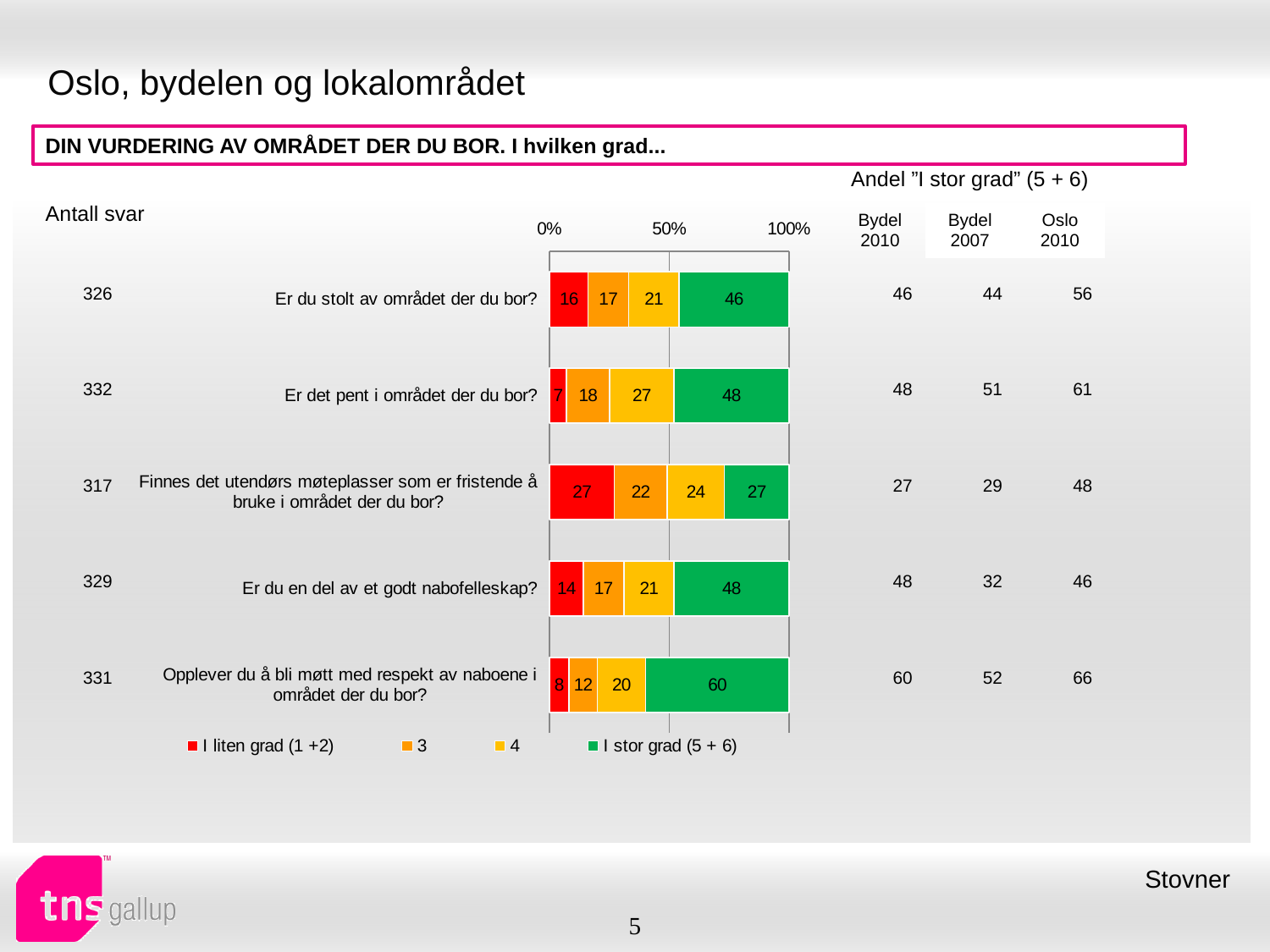
What is the value of series "4" for "Finnes det utendørs møteplasser som er fristende å bruke i området der du bor?"? 24 Which has a larger "I liten grad (1 +2)" value: "Er du stolt av området der du bor?" or "Er du en del av et godt nabofelleskap?"? Er du stolt av området der du bor? What is the value of "I stor grad (5 + 6)" for "Er du stolt av området der du bor?"? 46 How many questions (categories) are plotted in the chart? 5 What is the value of "I liten grad (1 +2)" for "Er det pent i området der du bor?"? 7 What kind of chart is shown on the slide? stacked bar chart Which question has the lowest "I stor grad (5 + 6)" value? Finnes det utendørs møteplasser som er fristende å bruke i området der du bor? Which question has the highest "I stor grad (5 + 6)" value? Opplever du å bli møtt med respekt av naboene i området der du bor? Which colour represents "I stor grad (5 + 6)" in the chart? green What is the difference between the "I stor grad (5 + 6)" values for "Opplever du å bli møtt med respekt av naboene i området der du bor?" and "Er du stolt av området der du bor?"? 14 What is the total of the stacked bar for "Er det pent i området der du bor?"? 100 How many series does the chart legend list? 4